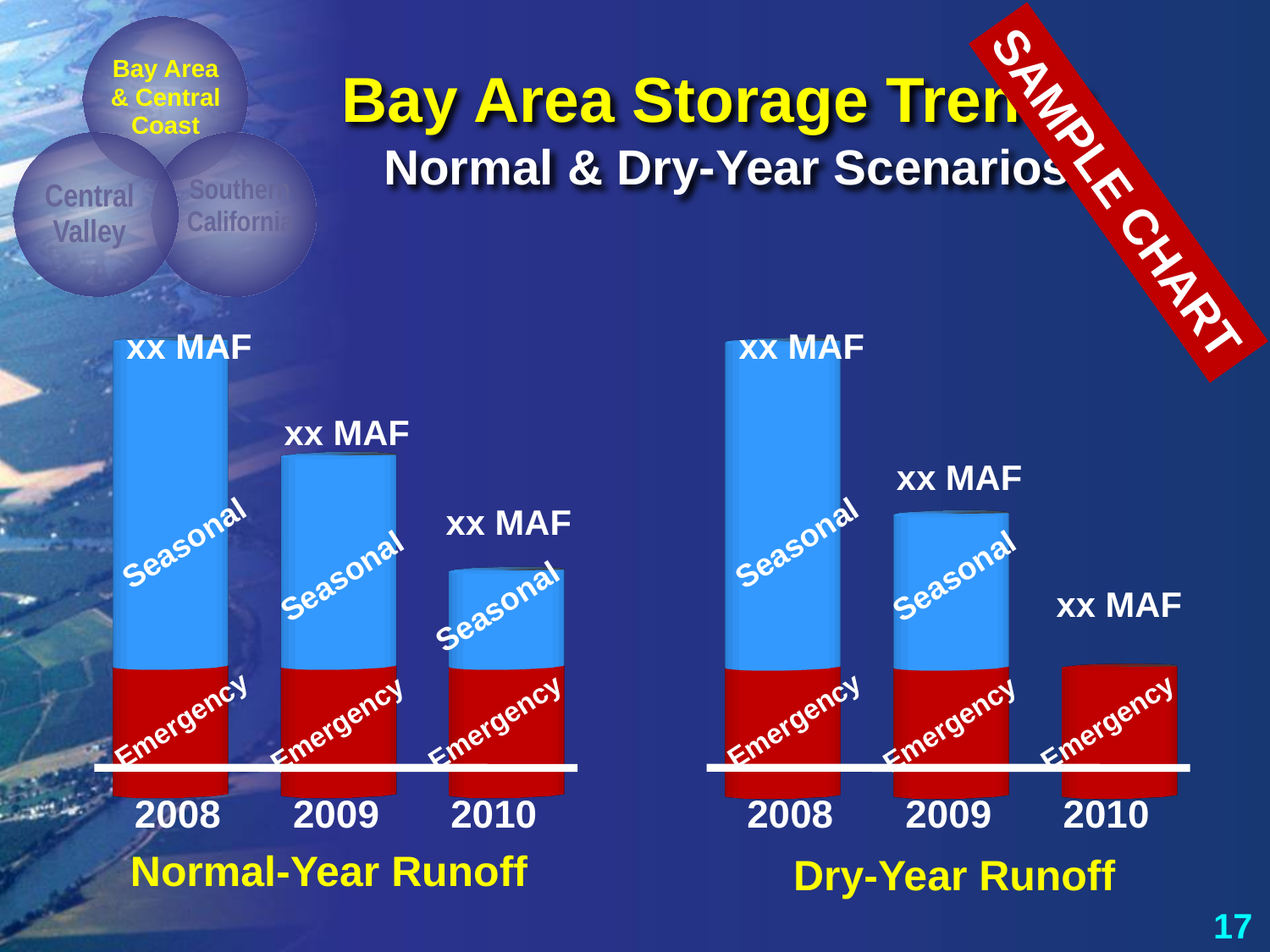
In the Dry-Year Runoff chart, do the bar heights rise or fall from 2008 to 2010? Fall How many years are shown on the x axis of the Dry-Year Runoff chart? 3 In the Normal-Year Runoff chart, which year has the shortest bar? 2010 How many years are shown on the x axis of the Normal-Year Runoff chart? 3 In the Dry-Year Runoff chart, is the 2009 bar taller or shorter than the 2010 bar? Taller In the Dry-Year Runoff chart, which year has the tallest bar? 2008 In the Normal-Year Runoff chart, do the bar heights rise or fall from 2008 to 2010? Fall In the Dry-Year Runoff chart, which segment is missing from the 2010 bar? Seasonal In the Dry-Year Runoff chart, which year has the shortest bar? 2010 In the Normal-Year Runoff chart, which year has the tallest bar? 2008 What are the two segments that make up each stacked bar in the Normal-Year Runoff chart? Seasonal and Emergency What kind of chart is the Normal-Year Runoff chart? Stacked bar chart